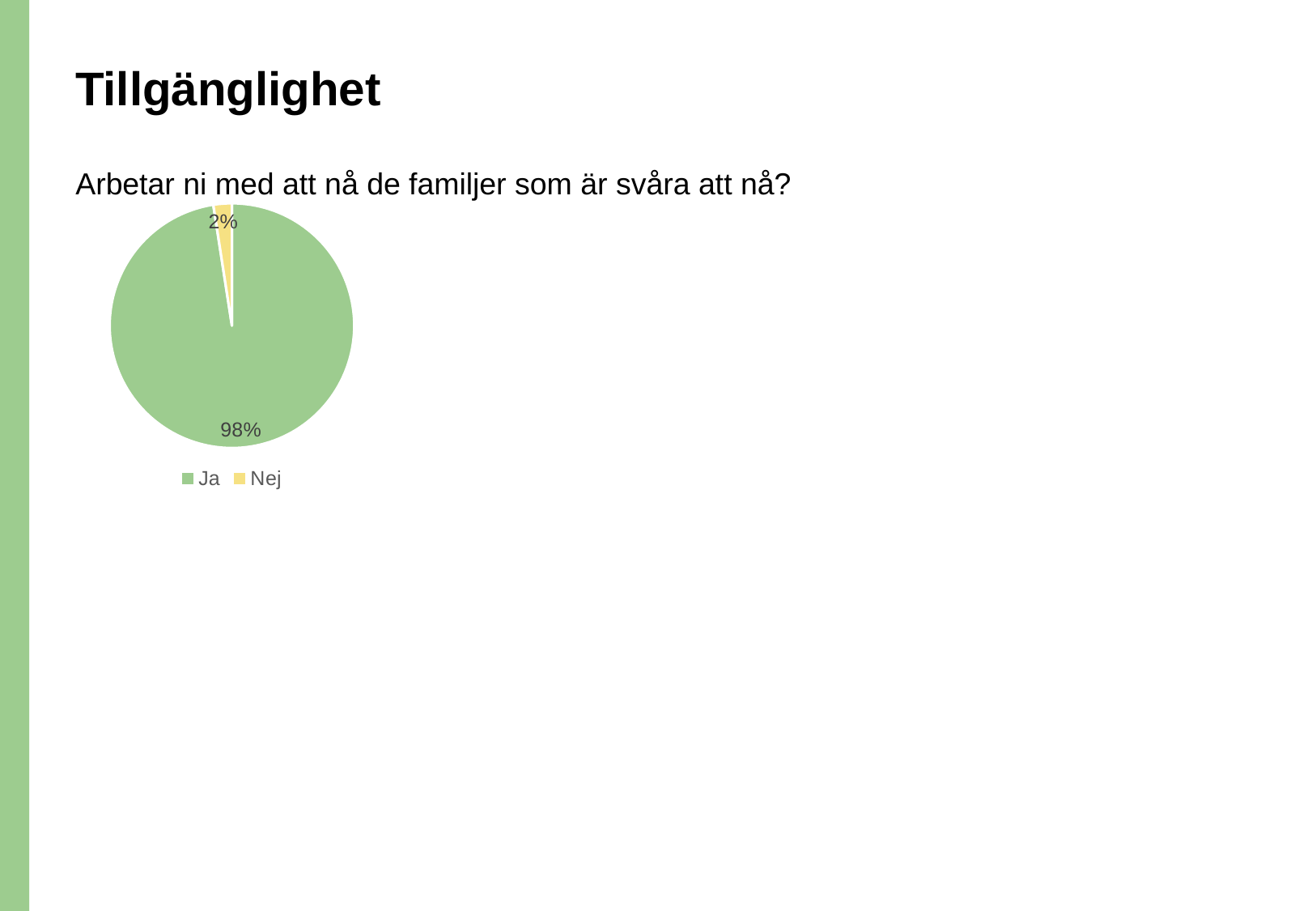
What kind of chart is shown on the slide? pie chart What question is the pie chart answering, as written above it? Arbetar ni med att nå de familjer som är svåra att nå? How many entries does the legend list? 2 What share of the pie is labelled "Ja"? 98% Which is larger, the "Ja" slice or the "Nej" slice? Ja What colour is the "Nej" slice in the pie chart? yellow Which slice of the pie is the largest? Ja How many slices does the pie chart have? 2 What is the difference in percentage points between the "Ja" and "Nej" slices? 96 What share of the pie is labelled "Nej"? 2% Which slice of the pie is the smallest? Nej